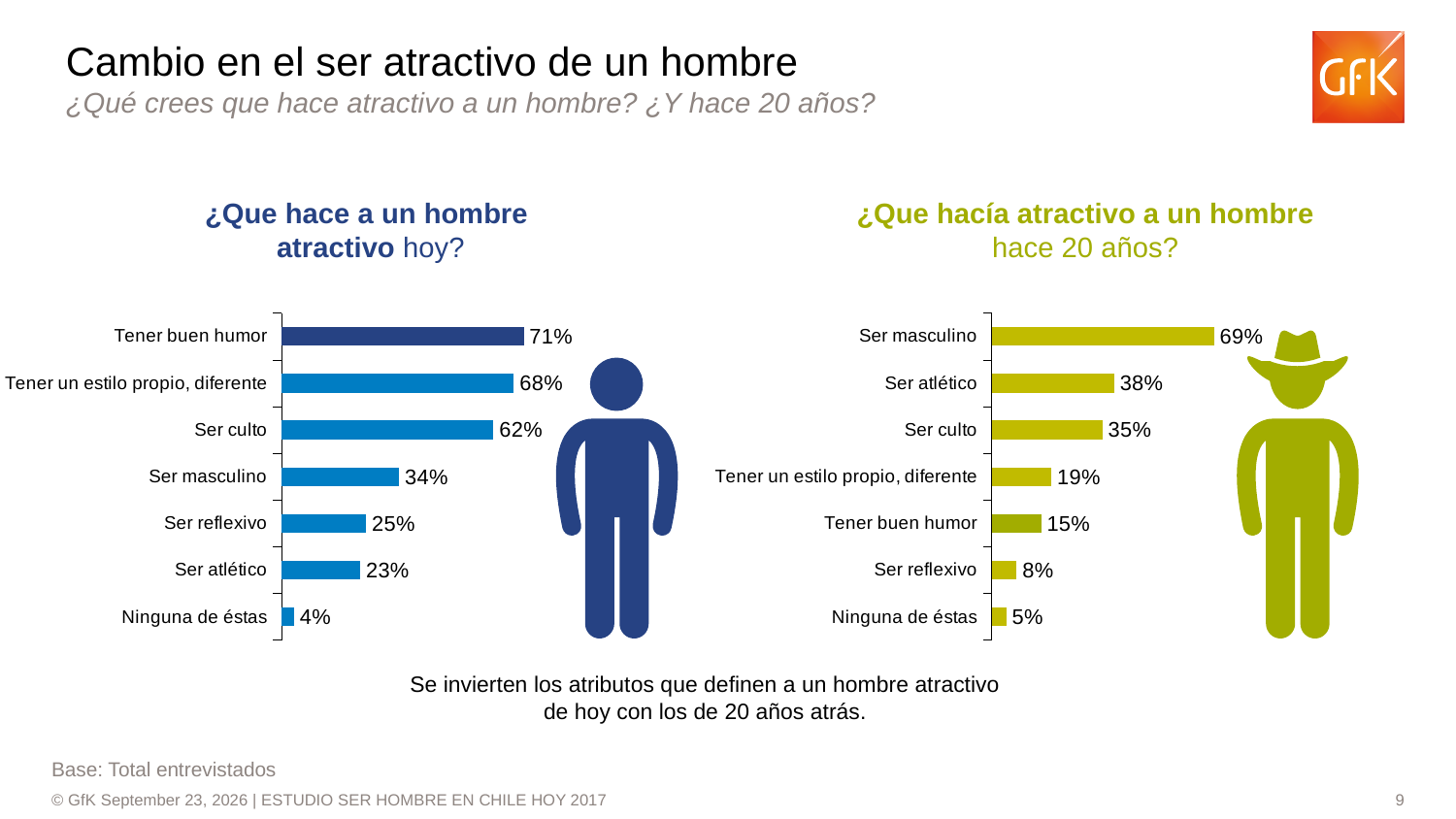
In the right chart (¿Que hacía atractivo a un hombre hace 20 años?), what is the difference between Ser masculino and Ser atlético? 31 percentage points In the right chart (¿Que hacía atractivo a un hombre hace 20 años?), which category has the lowest value? Ninguna de éstas In the left chart (¿Que hace a un hombre atractivo hoy?), which category has the highest value? Tener buen humor How many categories does the left chart (¿Que hace a un hombre atractivo hoy?) show? 7 What kind of chart is the right chart (¿Que hacía atractivo a un hombre hace 20 años?)? Bar chart Which is larger: Ser reflexivo in the left chart (hoy) or Ser reflexivo in the right chart (hace 20 años)? Left chart (hoy), 25% In the left chart (¿Que hace a un hombre atractivo hoy?), what is the value for Ser culto? 62% In the left chart (¿Que hace a un hombre atractivo hoy?), what is the difference between Tener buen humor and Ser masculino? 37 percentage points In the right chart (¿Que hacía atractivo a un hombre hace 20 años?), what is the value for Ser atlético? 38% What colour are the bars in the right chart (¿Que hacía atractivo a un hombre hace 20 años?)? Yellow-green In the right chart (¿Que hacía atractivo a un hombre hace 20 años?), which is larger: Ser culto or Tener un estilo propio, diferente? Ser culto In the left chart (¿Que hace a un hombre atractivo hoy?), what is the value for Ninguna de éstas? 4%